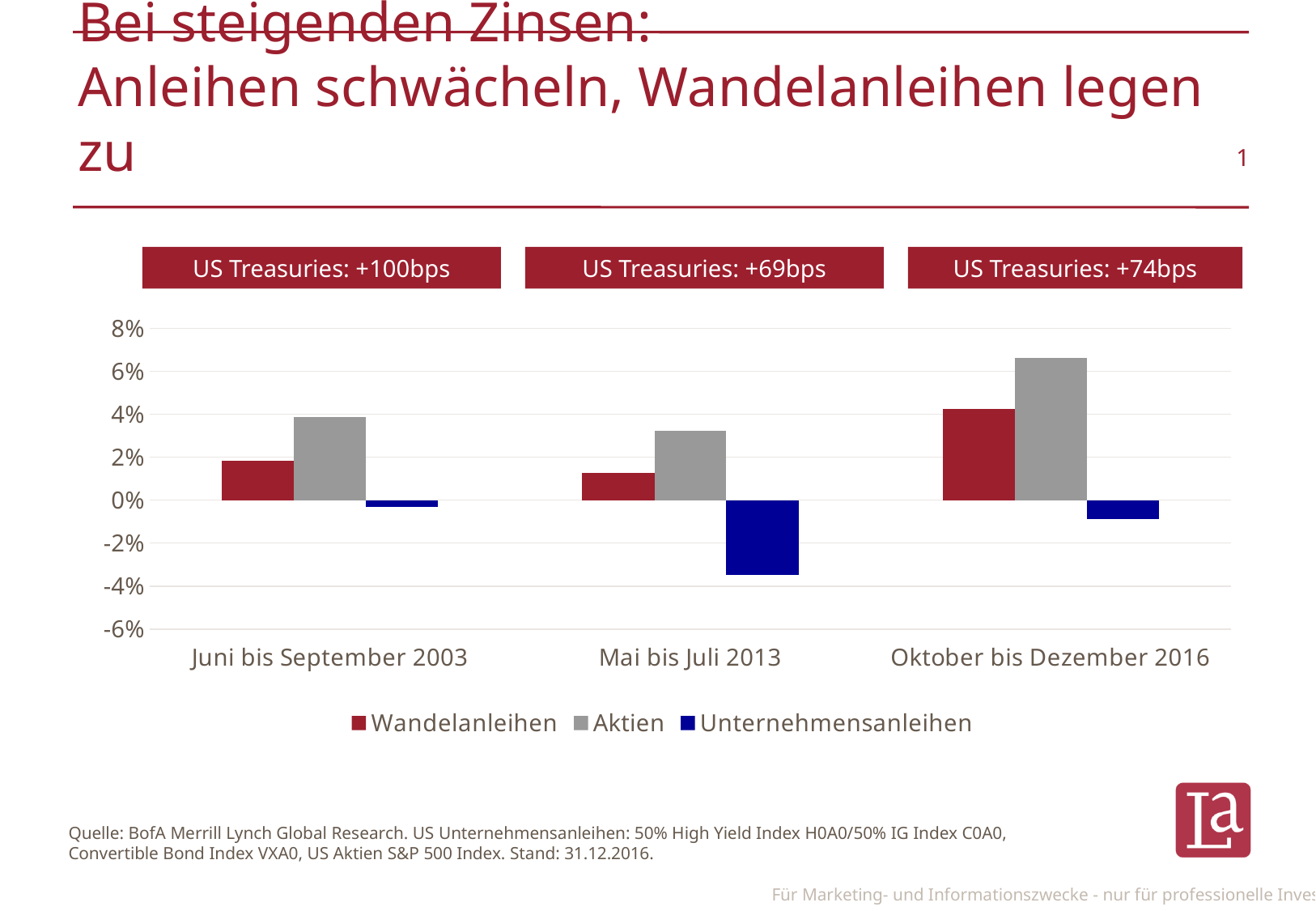
What US Treasuries change is shown in the box above the period Juni bis September 2003? +100bps How many time periods are shown on the x axis of the chart? 3 Is the value for Aktien in Oktober bis Dezember 2016 greater or less than 6%? greater Is the value for Unternehmensanleihen in Mai bis Juli 2013 greater or less than -2%? less Which series has the highest value in the period Mai bis Juli 2013? Aktien How many series does the chart legend list? 3 What kind of chart is shown on the slide? bar chart In which period is the value for Aktien the highest? Oktober bis Dezember 2016 In which period is the value for Unternehmensanleihen the lowest? Mai bis Juli 2013 Is the value for Wandelanleihen in Oktober bis Dezember 2016 greater or less than 2%? greater Is the value for Wandelanleihen larger in Juni bis September 2003 or in Mai bis Juli 2013? Juni bis September 2003 In the period Juni bis September 2003, which is larger: Wandelanleihen or Aktien? Aktien